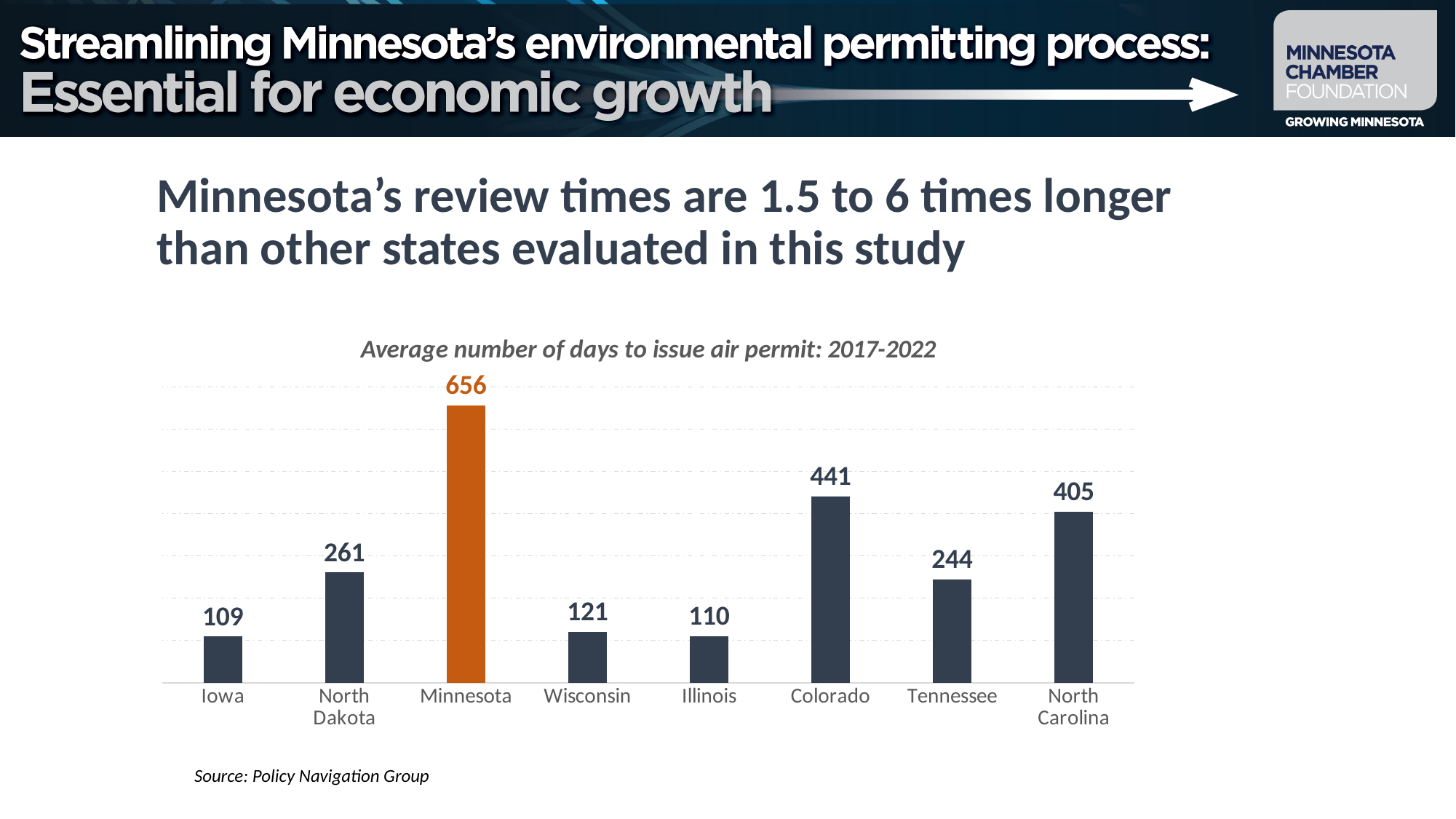
Which has a larger value, Tennessee or North Dakota? North Dakota How many states are shown in the chart? 8 Which state has the highest average number of days to issue an air permit? Minnesota What is the difference between North Dakota's value and Wisconsin's value? 140 What is the difference between Minnesota's value and North Carolina's value? 251 Which has a larger value, Colorado or North Carolina? Colorado What kind of chart is shown on the slide? Bar chart What is the average number of days to issue an air permit in Minnesota? 656 Which state has the lowest average number of days to issue an air permit? Iowa What is the title of the chart? Average number of days to issue air permit: 2017-2022 What is the average number of days to issue an air permit in Colorado? 441 What is the value shown for Tennessee? 244